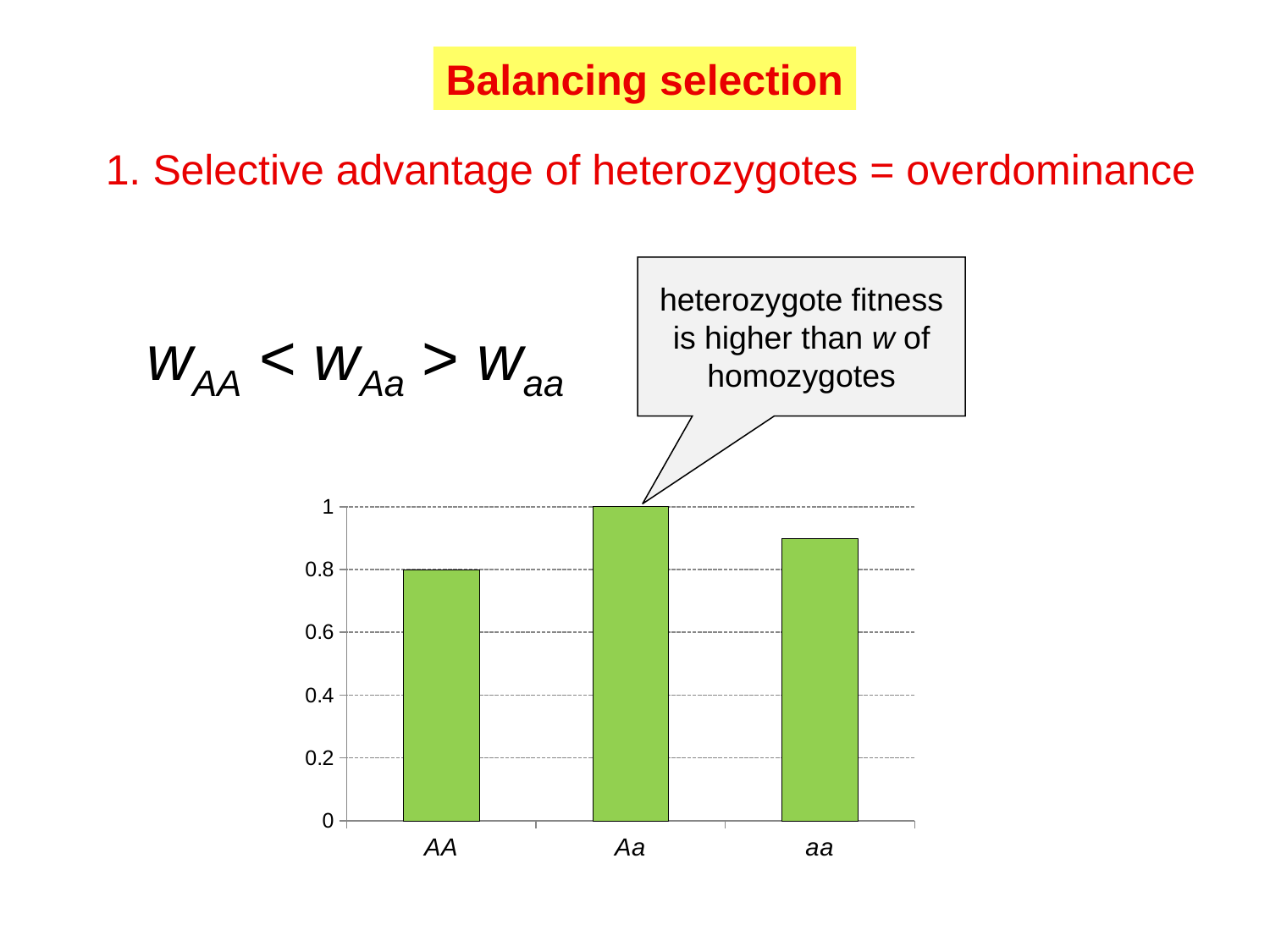
Is the value for aa greater or less than 0.8? greater Which genotype has the highest bar? Aa Which bar is taller, Aa or aa? Aa What colour are the bars in the chart? green What is the value of the bar for AA? 0.8 What is the difference between the bars for Aa and AA? 0.2 What type of chart is shown on the slide? bar chart Which genotype has the lowest bar? AA Is the value for aa greater or less than 1? less How many genotype categories are plotted on the x axis? 3